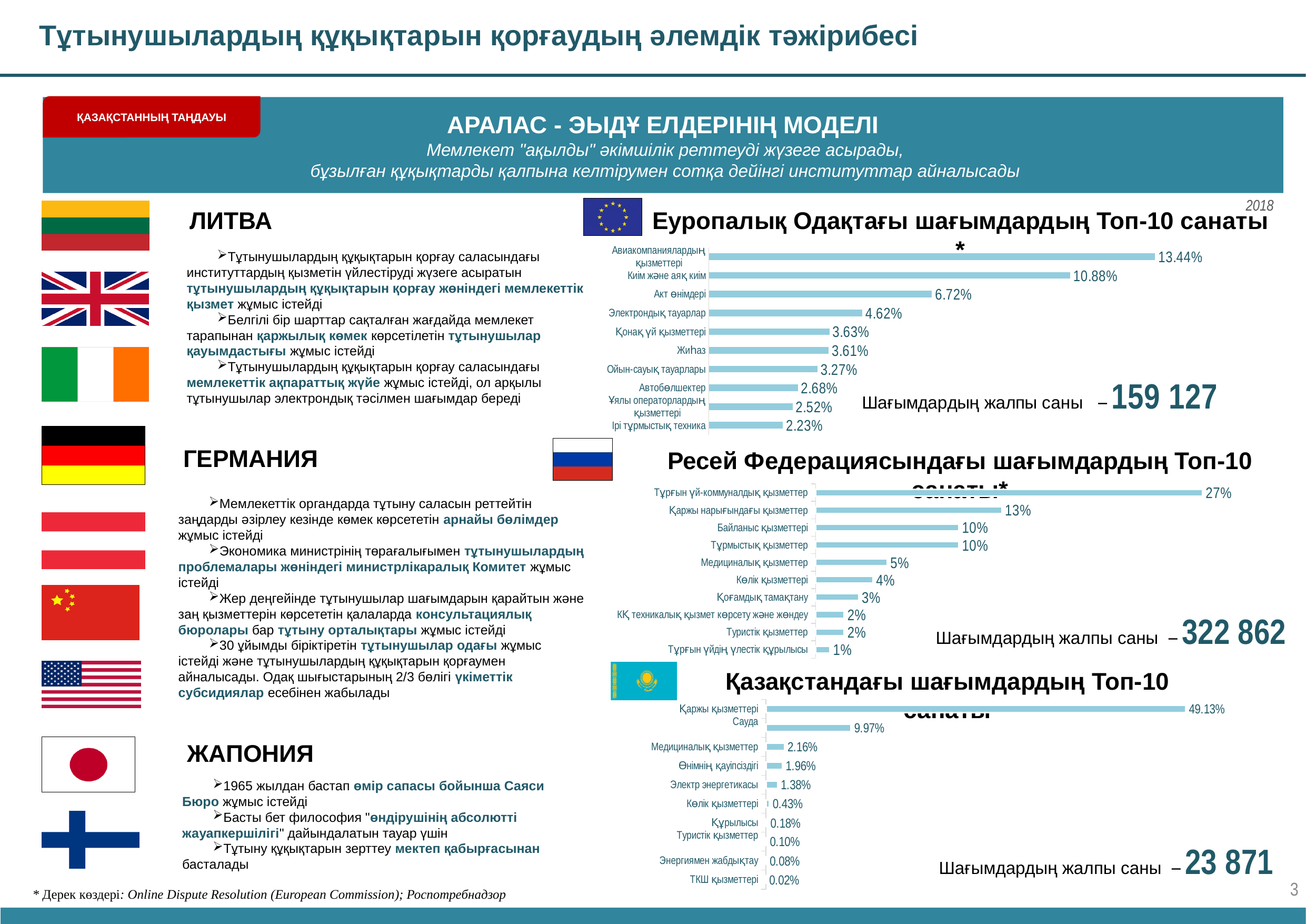
In the chart 'Қазақстандағы шағымдардың Топ-10 санаты', which category has the highest value? Қаржы қызметтері In the chart 'Ресей Федерациясындағы шағымдардың Топ-10 санаты', what is the difference between 'Тұрғын үй-коммуналдық қызметтер' and 'Қаржы нарығындағы қызметтер'? 14% In the chart 'Еуропалық Одақтағы шағымдардың Топ-10 санаты', what is the value for 'Киім және аяқ киім'? 10.88% In the chart 'Ресей Федерациясындағы шағымдардың Топ-10 санаты', what is the value for 'Тұрғын үй-коммуналдық қызметтер'? 27% In the chart 'Қазақстандағы шағымдардың Топ-10 санаты', what is the value for 'ТКШ қызметтері'? 0.02% In the chart 'Ресей Федерациясындағы шағымдардың Топ-10 санаты', which category has the lowest value? Тұрғын үйдің үлестік құрылысы In the chart 'Еуропалық Одақтағы шағымдардың Топ-10 санаты', how many categories are plotted? 10 In the chart 'Қазақстандағы шағымдардың Топ-10 санаты', what is the value for 'Сауда'? 9.97% In the chart 'Еуропалық Одақтағы шағымдардың Топ-10 санаты', what is the difference between 'Акт өнімдері' and 'Электрондық тауарлар'? 2.10% In the chart 'Ресей Федерациясындағы шағымдардың Топ-10 санаты', which is larger: 'Қаржы нарығындағы қызметтер' or 'Медициналық қызметтер'? Қаржы нарығындағы қызметтер In the chart 'Еуропалық Одақтағы шағымдардың Топ-10 санаты', which category has the highest value? Авиакомпаниялардың қызметтері What type of chart is 'Қазақстандағы шағымдардың Топ-10 санаты'? Bar chart